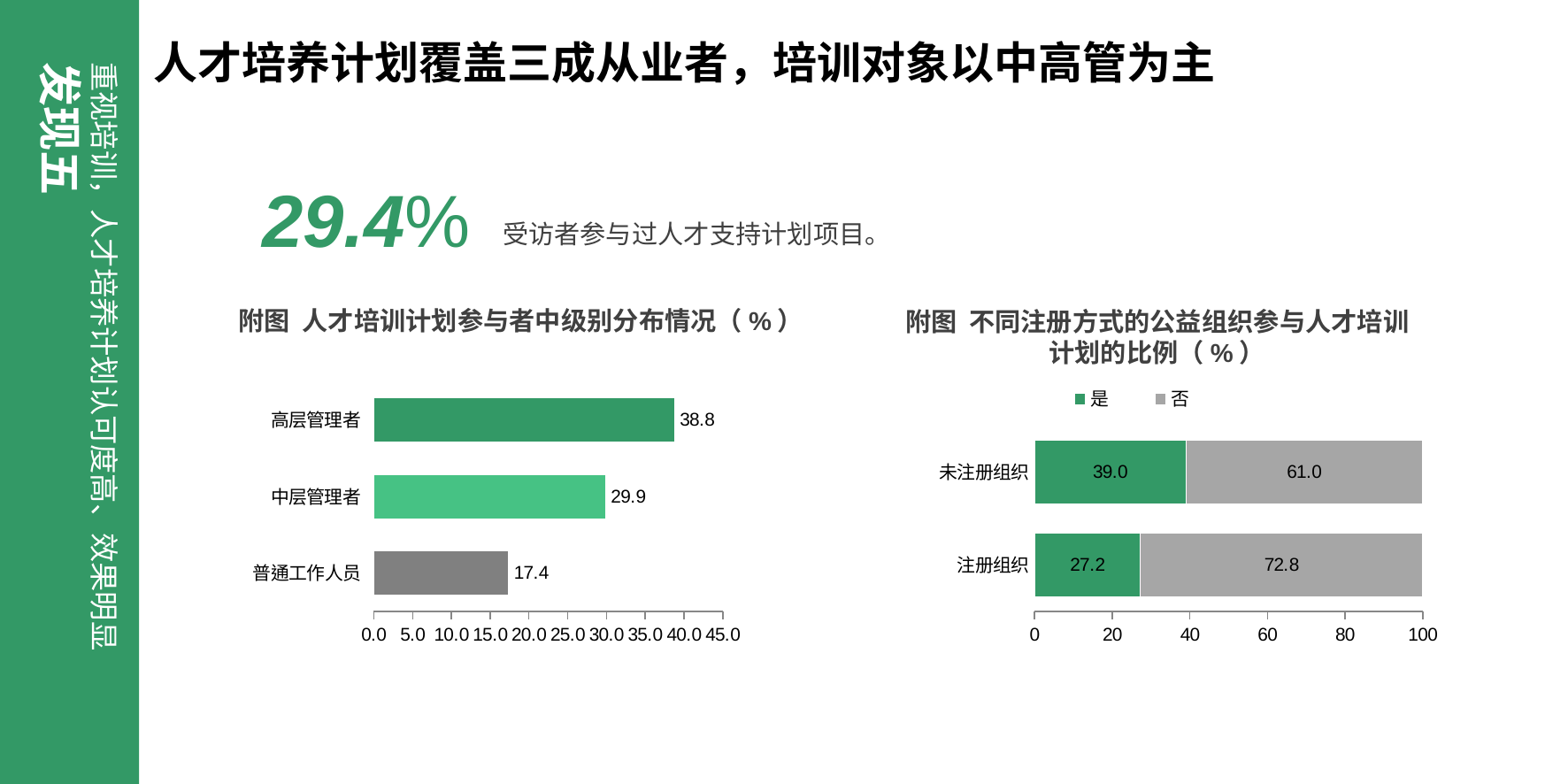
In the right chart (不同注册方式的公益组织参与人才培训计划的比例), what is the total of the stacked bar for 注册组织? 100.0 In the left chart (人才培训计划参与者中级别分布情况), how many categories are shown? 3 How many series does the legend of the right chart (不同注册方式的公益组织参与人才培训计划的比例) list? 2 In the left chart (人才培训计划参与者中级别分布情况), what is the value for 普通工作人员? 17.4 In the left chart (人才培训计划参与者中级别分布情况), which category has the highest value? 高层管理者 In the right chart (不同注册方式的公益组织参与人才培训计划的比例), which has the larger 是 value, 未注册组织 or 注册组织? 未注册组织 What kind of chart is the left chart (人才培训计划参与者中级别分布情况)? Bar chart In the right chart (不同注册方式的公益组织参与人才培训计划的比例), what is the 是 value for 注册组织? 27.2 In the left chart (人才培训计划参与者中级别分布情况), what is the difference between the values for 高层管理者 and 中层管理者? 8.9 In the left chart (人才培训计划参与者中级别分布情况), which category has the lowest value? 普通工作人员 In the right chart (不同注册方式的公益组织参与人才培训计划的比例), what is the 否 value for 未注册组织? 61.0 In the left chart (人才培训计划参与者中级别分布情况), what is the value for 高层管理者? 38.8